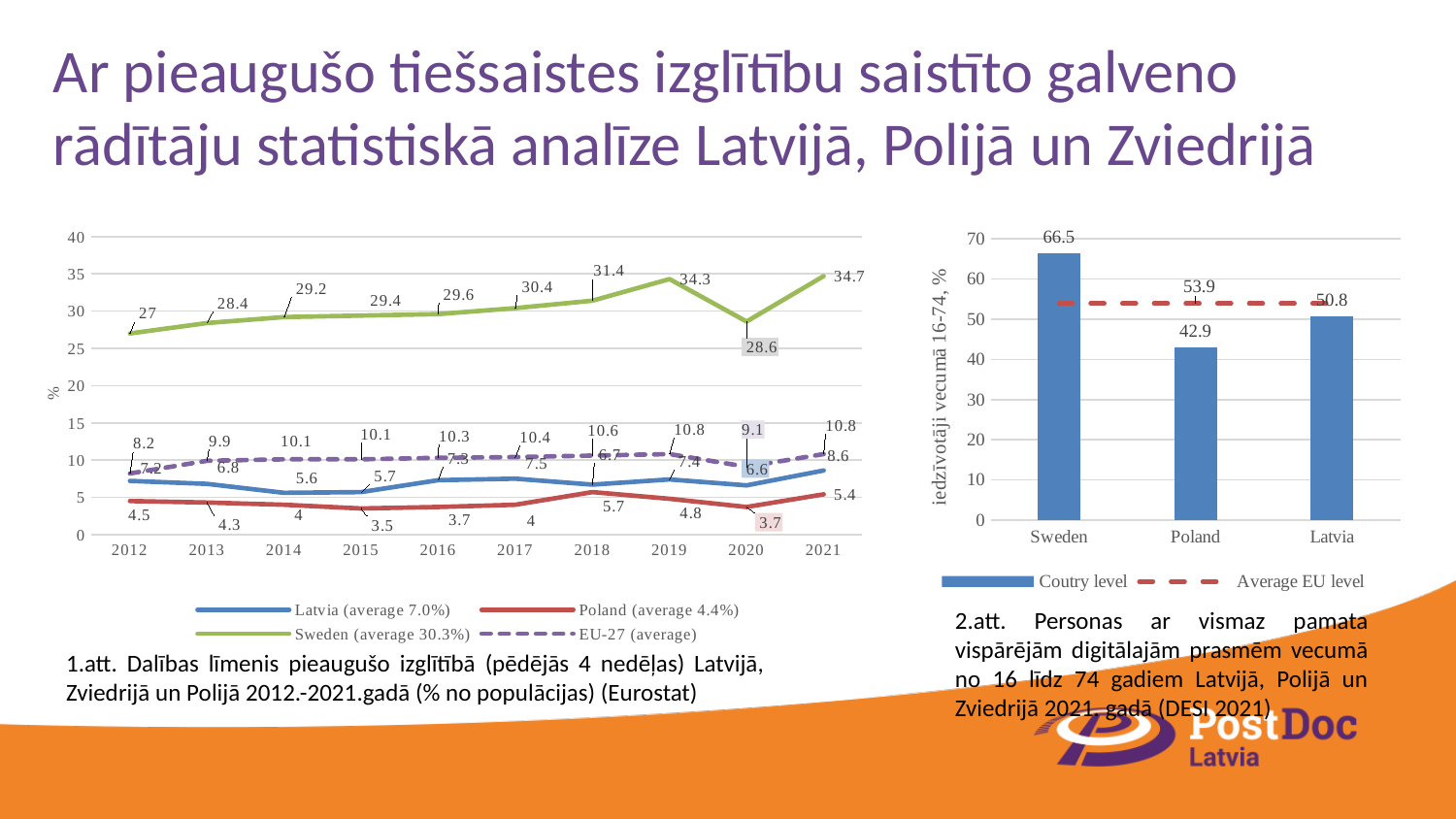
In the left chart (1.att.), what is the value for Latvia in 2021? 8.6 In the right chart (2.att.), what is the difference between Sweden's value and Latvia's value? 15.7 In the left chart (1.att.), what is the difference between Sweden's value in 2019 and in 2020? 5.7 In the left chart (1.att.), what is the value for Sweden in 2021? 34.7 In the left chart (1.att.), which year has the highest value for Sweden? 2021 In the left chart (1.att.), what is the value for Poland in 2015? 3.5 In the left chart (1.att.), how many series does the legend list? 4 In the right chart (2.att.), what is the Average EU level value? 53.9 In the right chart (2.att.), what is the country level value for Poland? 42.9 What kind of chart is the left chart (1.att.)? Line chart In the right chart (2.att.), which country has the highest country level value? Sweden In the left chart (1.att.), how many years are shown on the x axis? 10